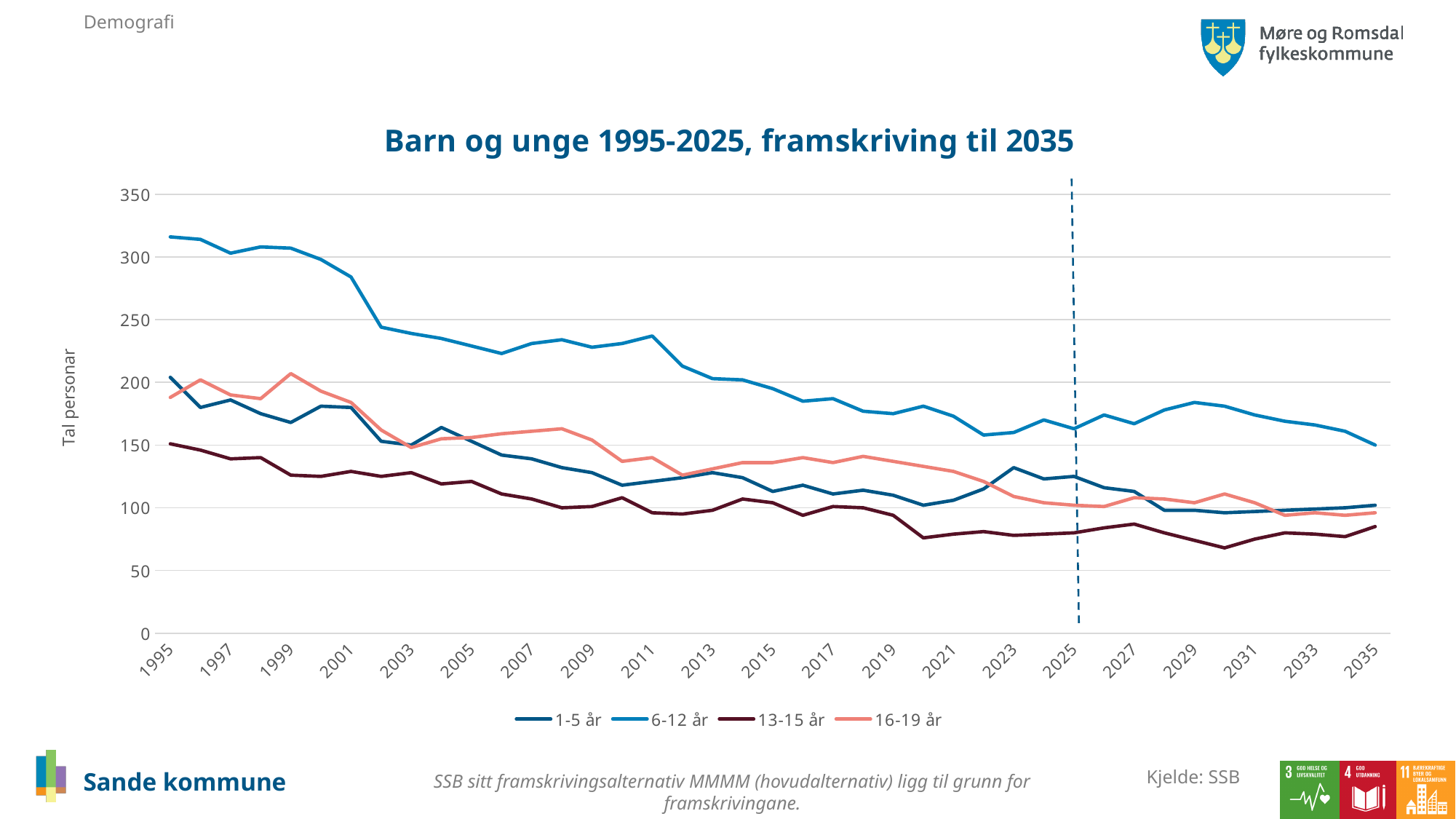
Is the value for 13-15 år in 2030 greater or less than 100? less What kind of chart is shown on the slide? Line chart In 2025, which is larger: the value for 6-12 år or the value for 13-15 år? 6-12 år Which series has the lowest value in 2035? 13-15 år How many series does the legend list? 4 Is the value for 6-12 år in 2011 greater or less than 200? greater Is the value for 6-12 år in 2035 greater or less than 200? less Does the 6-12 år series generally rise or fall from 1995 to 2035? Fall What is the label on the vertical axis? Tal personar What is the title of the chart? Barn og unge 1995-2025, framskriving til 2035 Which series has the highest value in 1995? 6-12 år